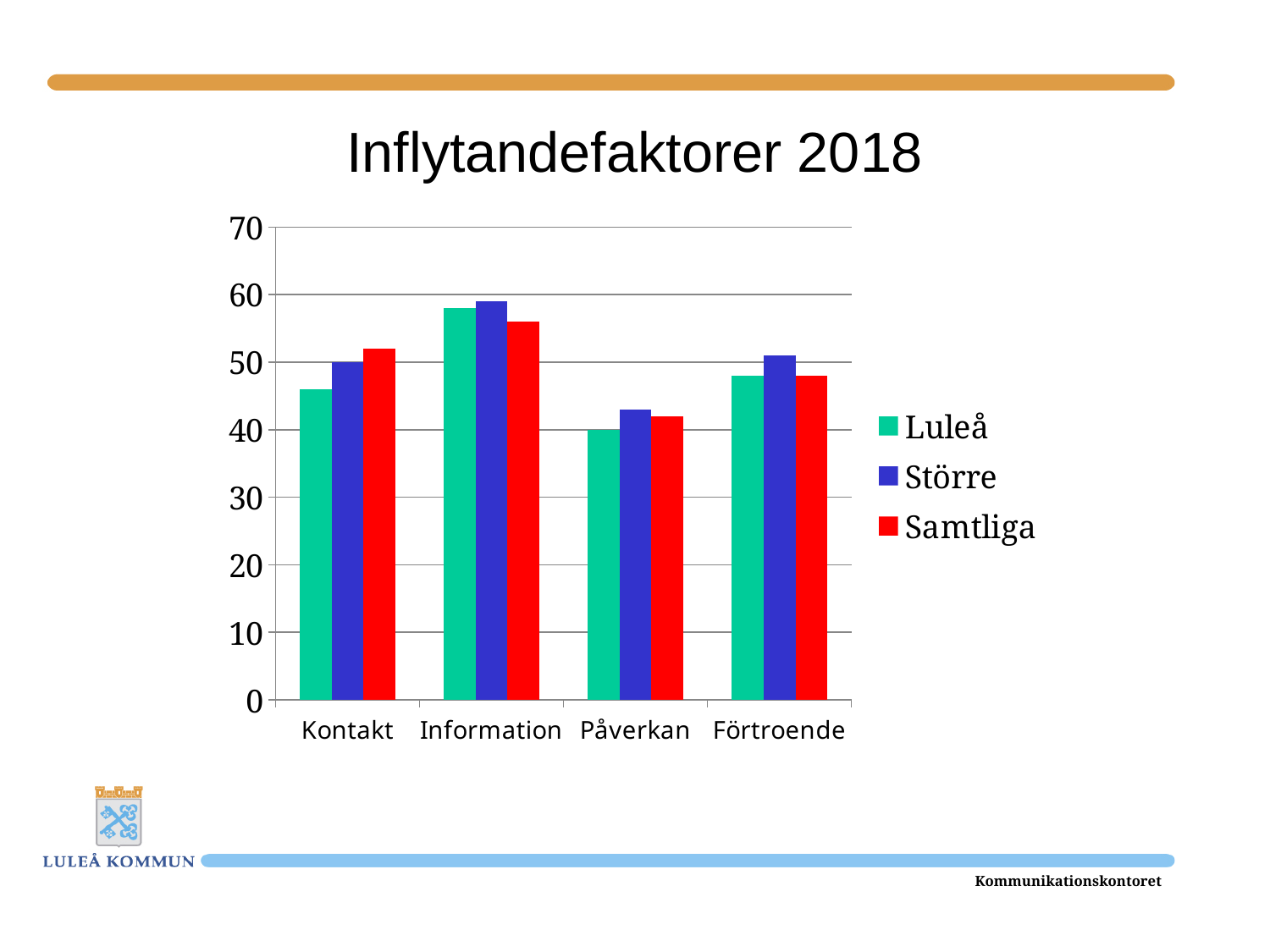
Is the value for Luleå in the Information category greater or less than 50? greater For the Samtliga series, which category has the lowest value? Påverkan What is the title of the chart? Inflytandefaktorer 2018 Is the value for Större in the Påverkan category greater or less than 50? less Which series is shown in red in the legend? Samtliga In the Kontakt category, which is larger: the value for Luleå or the value for Samtliga? Samtliga For the Luleå series, which category has the highest value? Information Is the value for Luleå in the Kontakt category greater or less than 50? less For the Större series, which is larger: the value for Information or the value for Påverkan? Information What kind of chart is shown on the slide? bar chart How many categories are shown on the x axis? 4 How many series does the legend list? 3